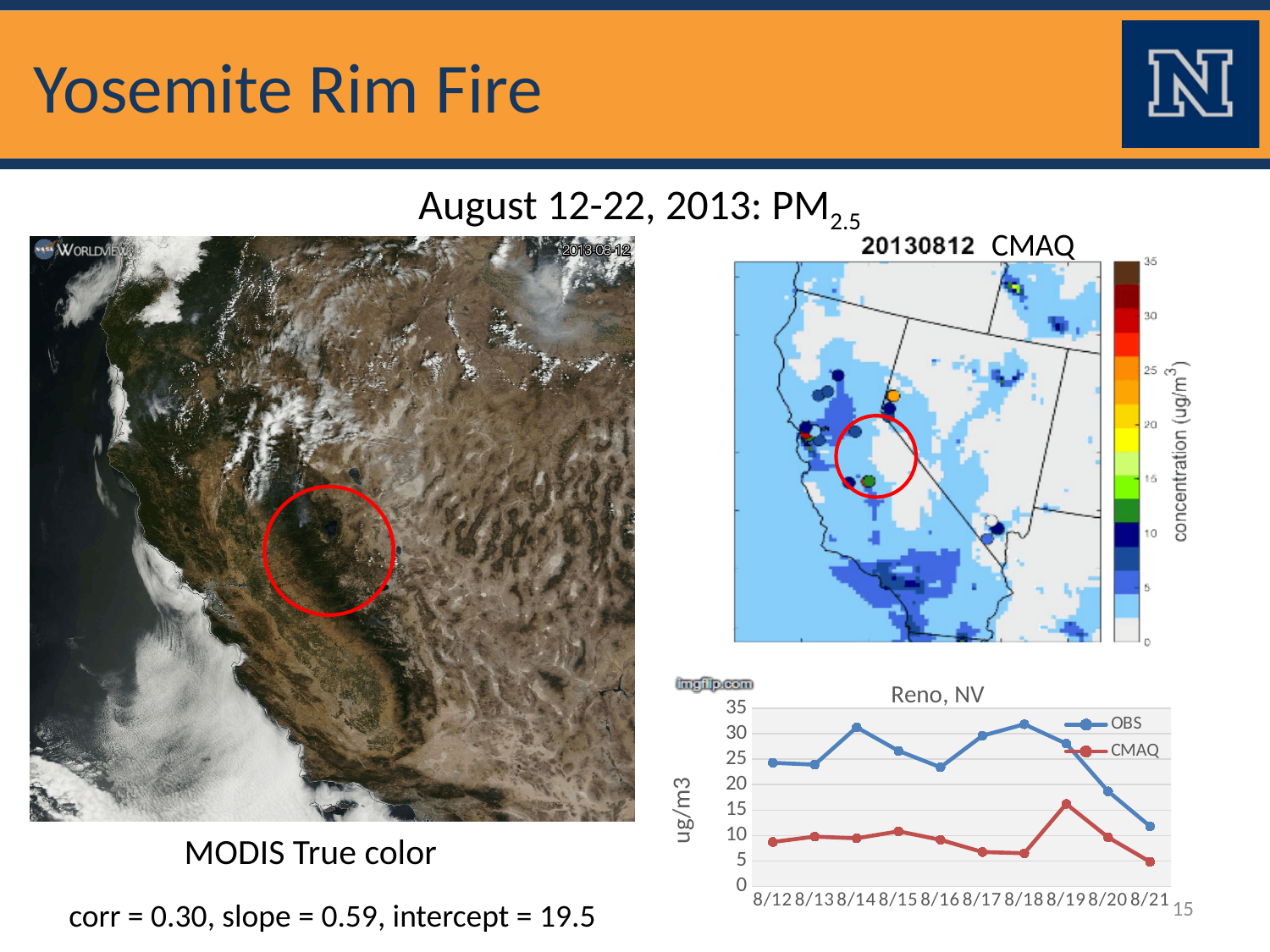
What kind of chart is the Reno, NV chart? line chart In the Reno, NV chart, on which date is the CMAQ value highest? 8/19 In the Reno, NV chart, is the OBS value for 8/21 greater or less than 15? less How many series does the legend of the Reno, NV chart list? 2 What is the y-axis label of the Reno, NV chart? ug/m3 In the Reno, NV chart, on which date is the OBS value lowest? 8/21 In the Reno, NV chart, which series has the larger value on 8/15, OBS or CMAQ? OBS In the Reno, NV chart, on which date is the CMAQ value lowest? 8/21 In the Reno, NV chart, does the OBS series rise or fall from 8/19 to 8/21? fall How many dates are plotted along the x axis of the Reno, NV chart? 10 In the Reno, NV chart, is the CMAQ value for 8/19 greater or less than 10? greater In the Reno, NV chart, is the OBS value for 8/18 greater or less than 30? greater